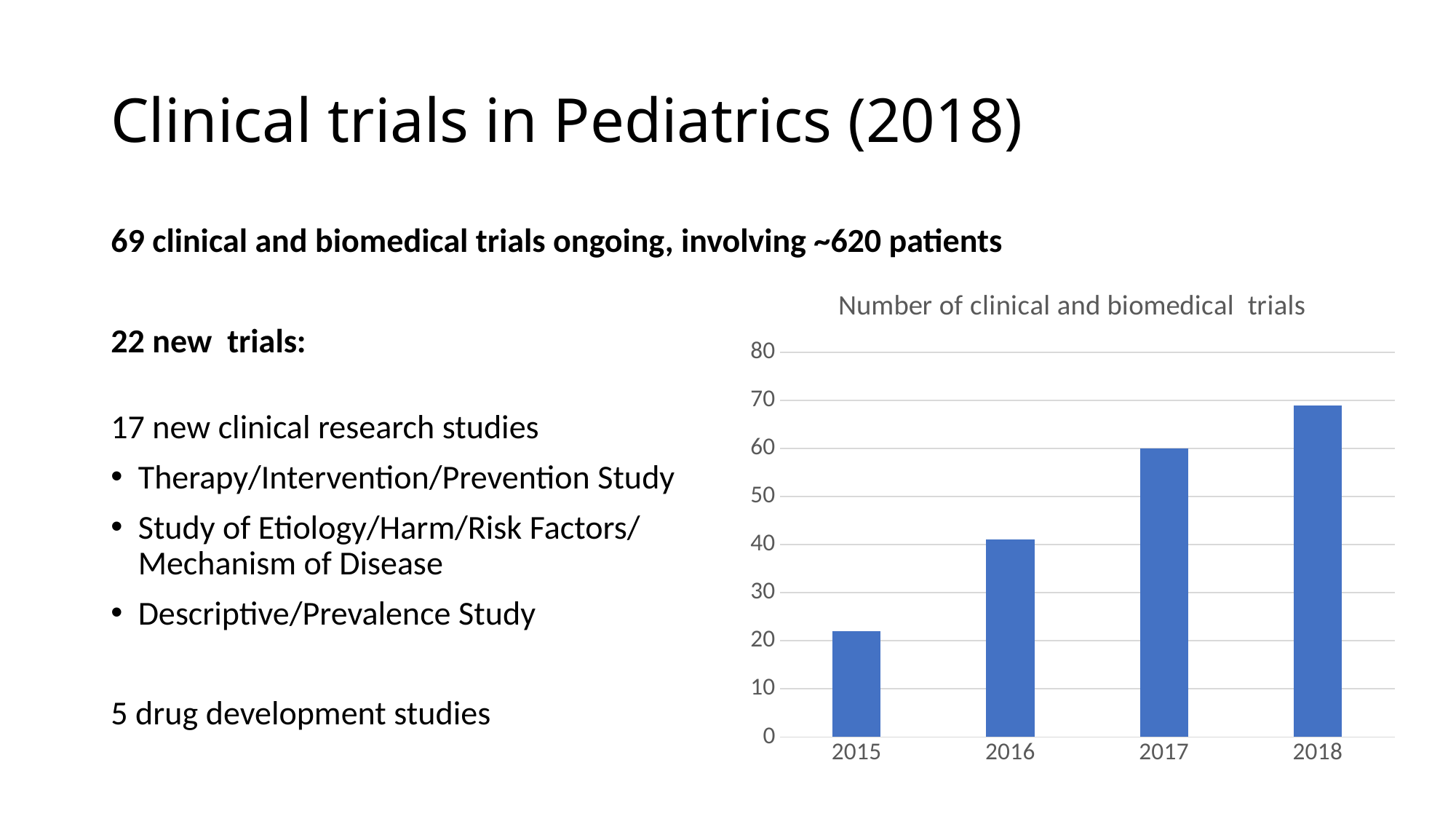
Is the value for 2016 greater or less than 50? less Is the value for 2018 greater or less than 60? greater Do the number of trials rise or fall from 2015 to 2018? rise Which year has the lowest number of clinical and biomedical trials? 2015 What colour are the bars in the chart? blue Which year has more trials, 2016 or 2017? 2017 How many years are shown on the x axis of the chart? 4 Which year has the highest number of clinical and biomedical trials? 2018 Is the value for 2015 greater or less than 30? less What type of chart is shown on the slide? bar chart What is the title of the chart? Number of clinical and biomedical trials What is the number of clinical and biomedical trials in 2017? 60